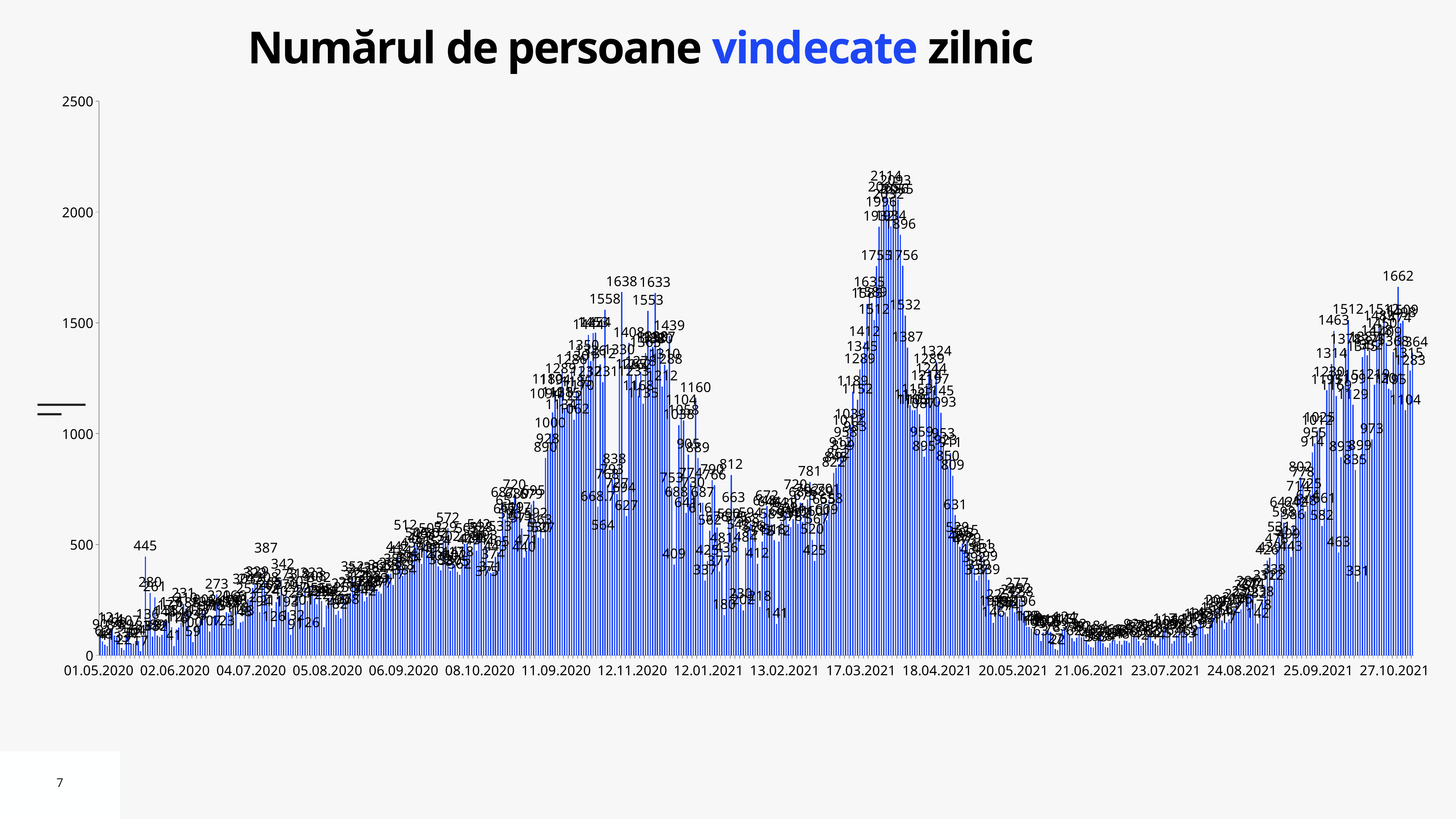
What is the value of the isolated spike labelled shortly before 02.06.2020? 445 What is the difference between the peak value 2114 and the autumn 2021 peak value 1662? 452 What kind of chart is shown on the slide? bar chart How many date labels are shown on the x axis? 18 Is the value for 01.05.2020 greater or less than 500? less What is the highest value labelled in the final wave near 27.10.2021? 1662 What is the title of the chart? Numărul de persoane vindecate zilnic Do the values rise or fall between 20.05.2021 and 21.06.2021? fall What is the highest data label shown on the chart? 2114 Which is larger: the peak value of 2114 in spring 2021 or the peak value of 1662 in autumn 2021? 2114 What is the difference between the two labelled peaks 1638 and 1633 in November 2020? 5 Are the values around 21.06.2021 greater or less than 500? less